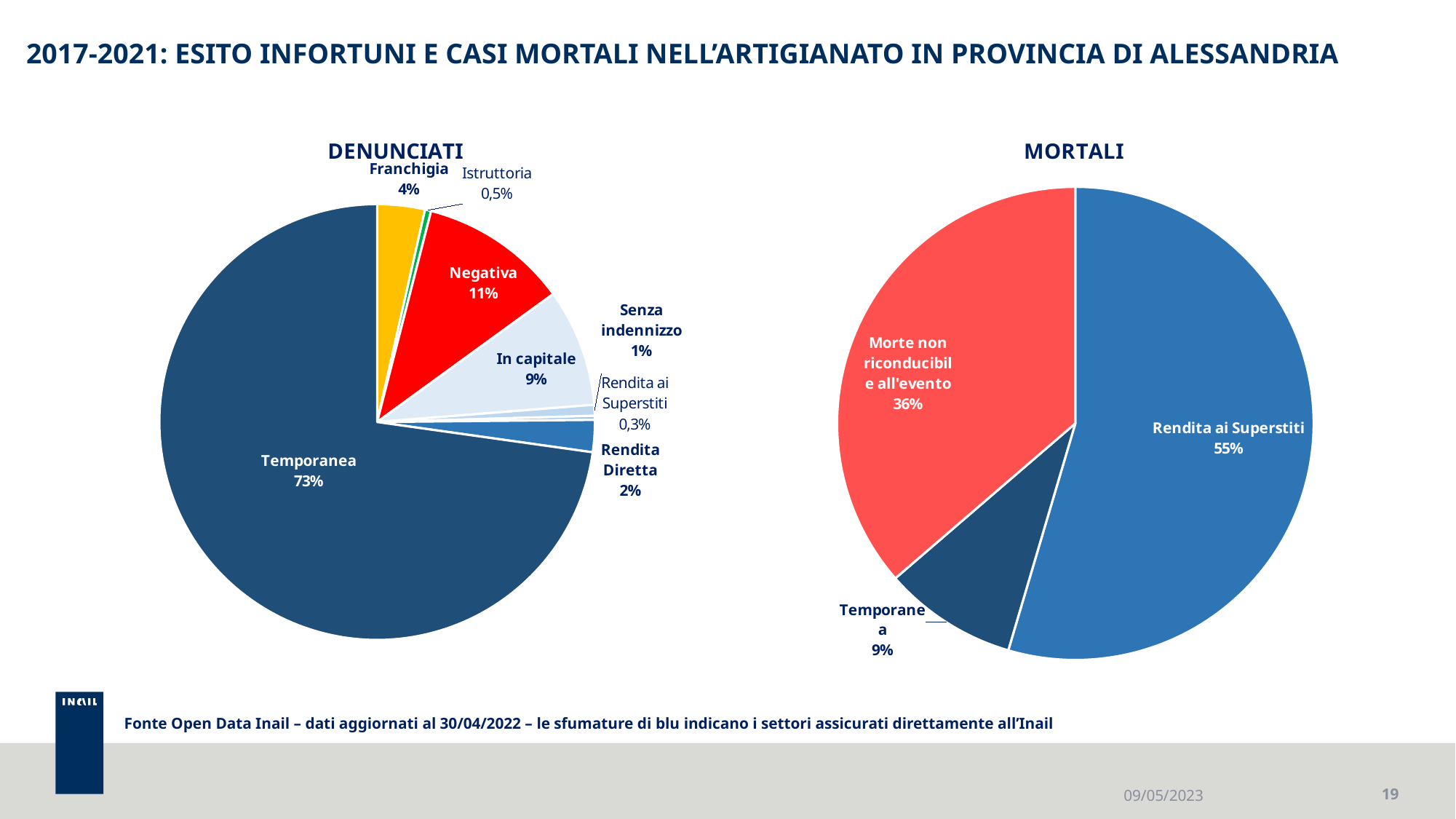
In the MORTALI chart, which is larger: Temporanea or Morte non riconducibile all'evento? Morte non riconducibile all'evento In the DENUNCIATI chart, what share does Temporanea have? 73% In the DENUNCIATI chart, which category has the smallest slice? Rendita ai Superstiti What type of chart is the MORTALI chart? Pie chart In the DENUNCIATI chart, how many categories are shown? 8 In the MORTALI chart, what share does Morte non riconducibile all'evento have? 36% In the DENUNCIATI chart, what share does In capitale have? 9% In the MORTALI chart, what share does Rendita ai Superstiti have? 55% In the DENUNCIATI chart, what share does Negativa have? 11% In the DENUNCIATI chart, what is the difference between Negativa and Franchigia? 7% In the DENUNCIATI chart, what share does Istruttoria have? 0,5% In the DENUNCIATI chart, which category has the largest slice? Temporanea